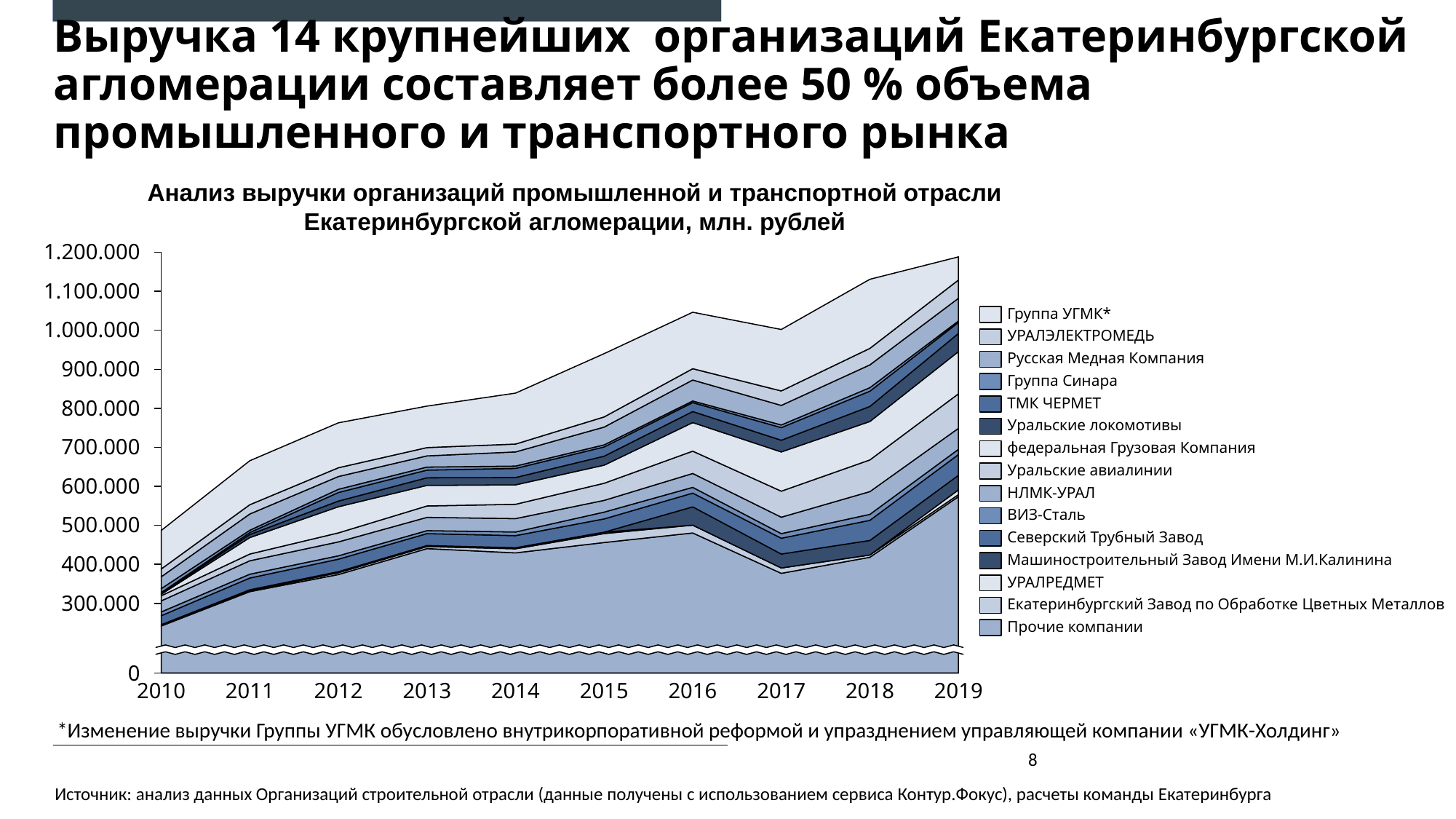
Which series is listed first in the chart legend? Группа УГМК* What is the unit of measurement stated in the chart title? млн. рублей Is the total revenue for 2011 greater or less than 700.000? less How many years are shown along the x axis of the chart? 10 Is the total revenue for 2016 greater or less than 1.000.000? greater Does the total revenue generally rise or fall from 2010 to 2019? Rise How many series does the legend of the chart list? 15 What kind of chart is shown on the slide? Stacked area chart Which year has the larger total revenue, 2016 or 2017? 2016 Which year has the lowest total revenue in the chart? 2010 Which year has the highest total revenue in the chart? 2019 Is the total revenue for 2019 greater or less than 1.100.000? greater